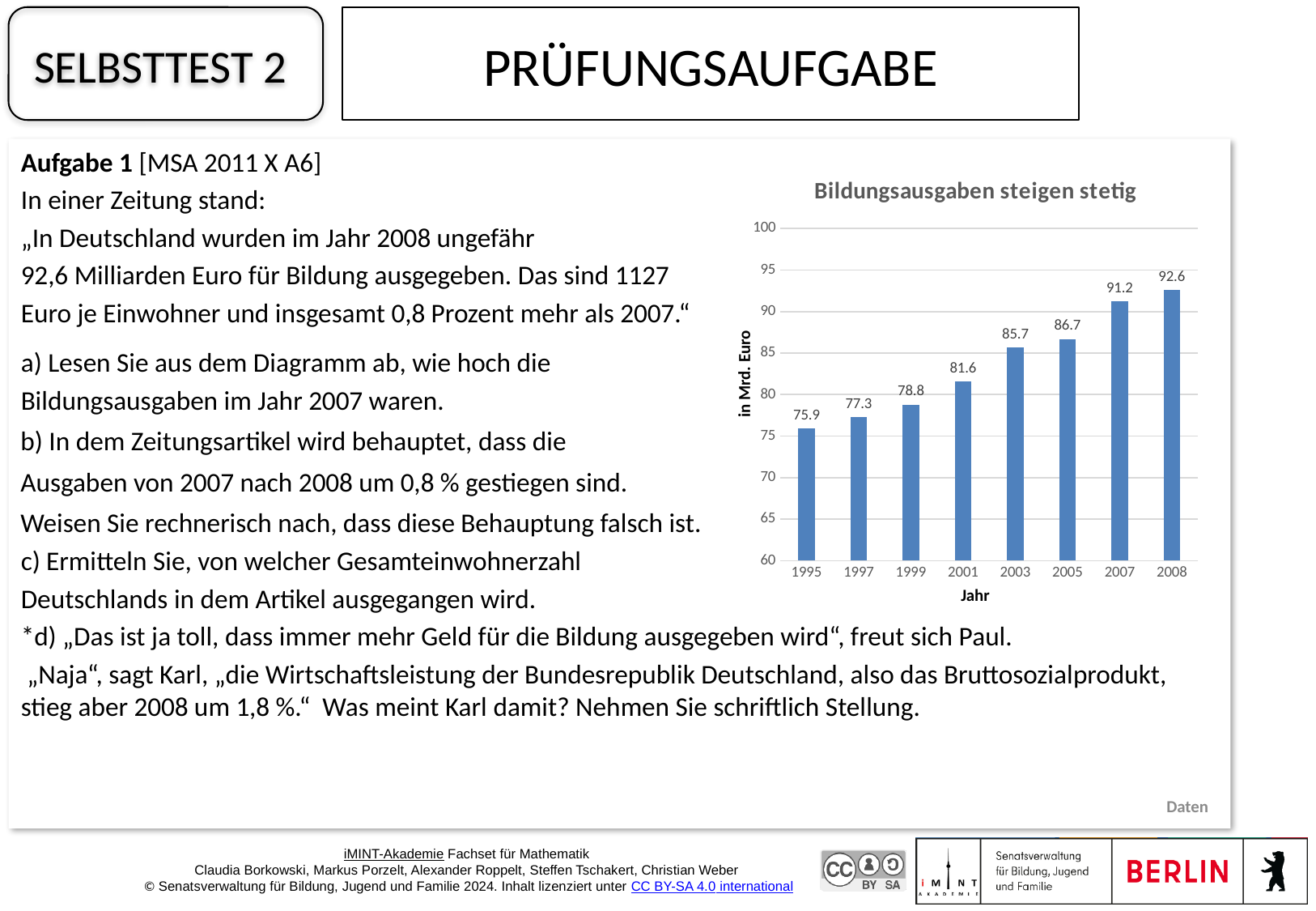
Which year has the highest value in the chart? 2008 Is the value for 1997 greater or less than 80? less Which year has the lowest value in the chart? 1995 What were the Bildungsausgaben in 2007 according to the chart? 91.2 What value is shown for the year 2003? 85.7 Do the values rise or fall from 1995 to 2008? rise What value is shown for the year 1995? 75.9 What is the difference between the values for 2008 and 2007? 1.4 What is the difference between the values for 2001 and 1999? 2.8 How many years are shown on the x axis of the chart? 8 Which is larger, the value for 2005 or the value for 2003? 2005 What kind of chart is shown on the slide? bar chart